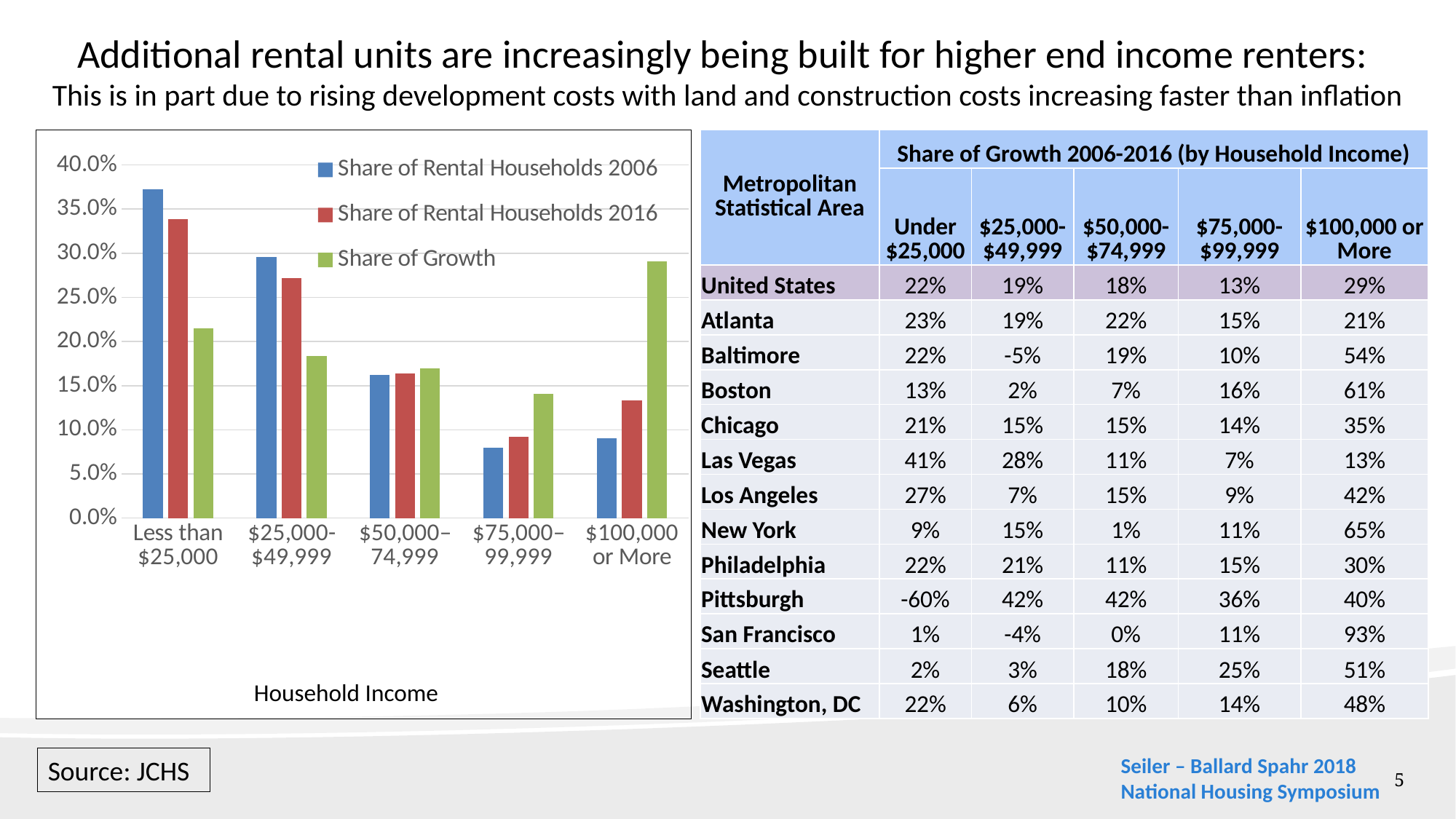
In the bar chart, which household income category has the highest Share of Growth? $100,000 or More In the bar chart, is the Share of Rental Households 2016 for $25,000-$49,999 greater or less than 25.0%? greater How many series does the legend of the bar chart list? 3 What kind of chart is shown on the left of the slide? Bar chart In the bar chart, for the $100,000 or More category, which is larger: Share of Rental Households 2006 or Share of Growth? Share of Growth In the bar chart, which household income category has the highest Share of Rental Households 2006? Less than $25,000 What is the x-axis title of the bar chart? Household Income How many household income categories are shown on the x axis of the bar chart? 5 In the bar chart, is the Share of Growth for $100,000 or More greater or less than 25.0%? greater In the bar chart, for the Less than $25,000 category, which is larger: Share of Rental Households 2006 or Share of Rental Households 2016? Share of Rental Households 2006 In the bar chart, which household income category has the lowest Share of Rental Households 2016? $75,000–99,999 In the bar chart, is the Share of Rental Households 2006 for Less than $25,000 greater or less than 35.0%? greater